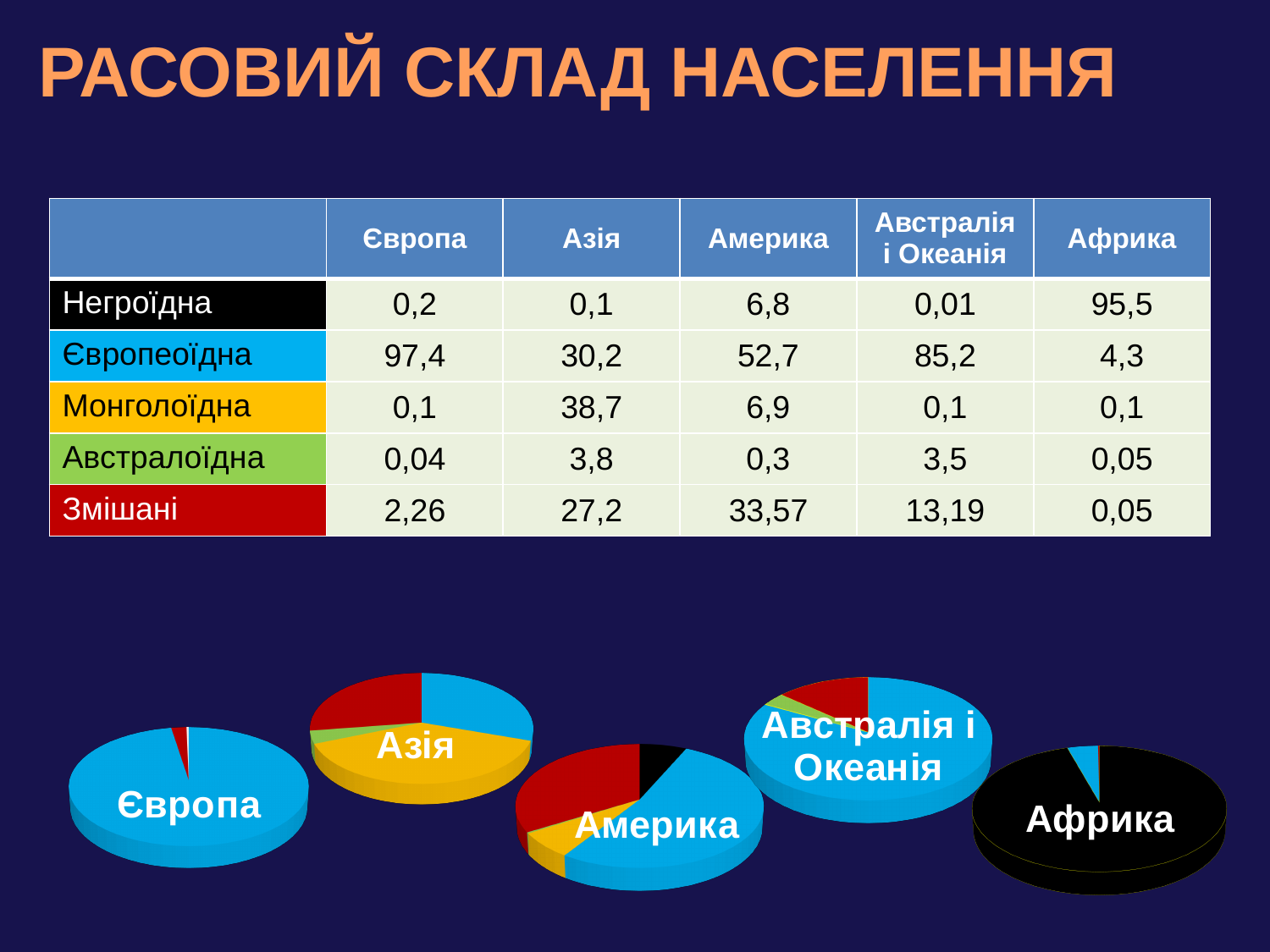
Which colour represents Монголоїдна in the pie charts? Yellow In the Африка pie chart, which race has the largest share? Негроїдна In the Європа pie chart, which race has the largest share? Європеоїдна Which pie chart is almost entirely black? Африка How many pie charts are on the slide? 5 In the Америка pie chart, which is larger: the Негроїдна slice or the Змішані slice? Змішані In the Америка pie chart, what is the share of Європеоїдна according to the table? 52,7 What is the difference between the Європеоїдна share in Європа and in Африка, using the table values? 93,1 In the Австралія і Океанія pie chart, what is the share of Змішані according to the table? 13,19 What kind of charts are shown at the bottom of the slide? Pie charts In the Азія pie chart, which is larger: the Європеоїдна slice or the Змішані slice? Європеоїдна In the Азія pie chart, which race has the largest share? Монголоїдна